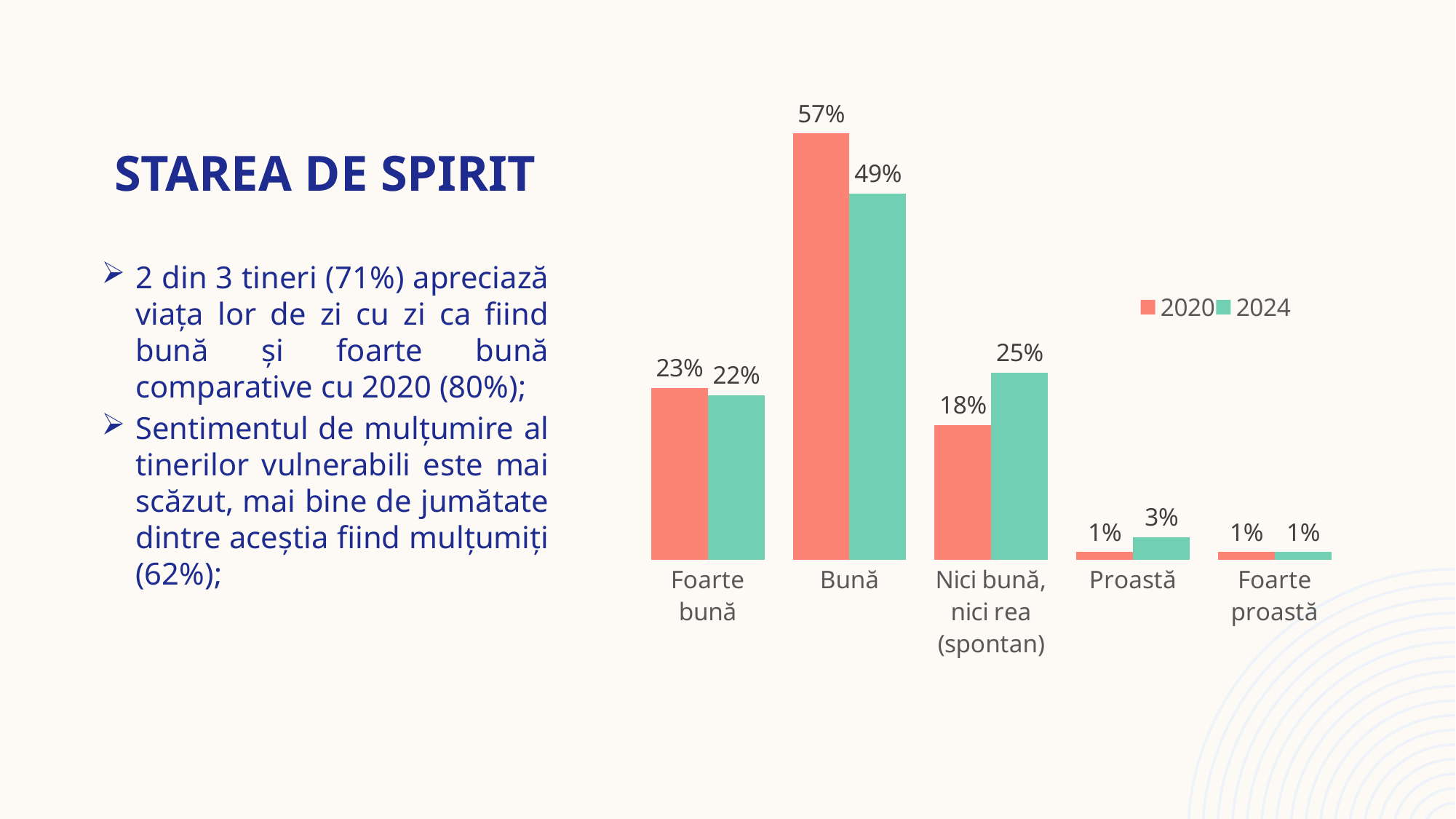
How many series does the legend list? 2 What is the 2024 value for 'Nici bună, nici rea (spontan)'? 25% Which category has the lowest 2024 value? Foarte proastă What is the 2024 value for 'Proastă'? 3% What kind of chart is shown on the slide? Bar chart How many categories are shown on the x axis? 5 What is the difference between the 2024 and 2020 values for 'Nici bună, nici rea (spontan)'? 7% Which series is shown in green in the legend? 2024 What is the difference between the 2020 and 2024 values for 'Bună'? 8% What is the 2020 value for the 'Bună' category? 57% Which is larger for 'Foarte bună': the 2020 value or the 2024 value? 2020 Which category has the highest 2024 value? Bună